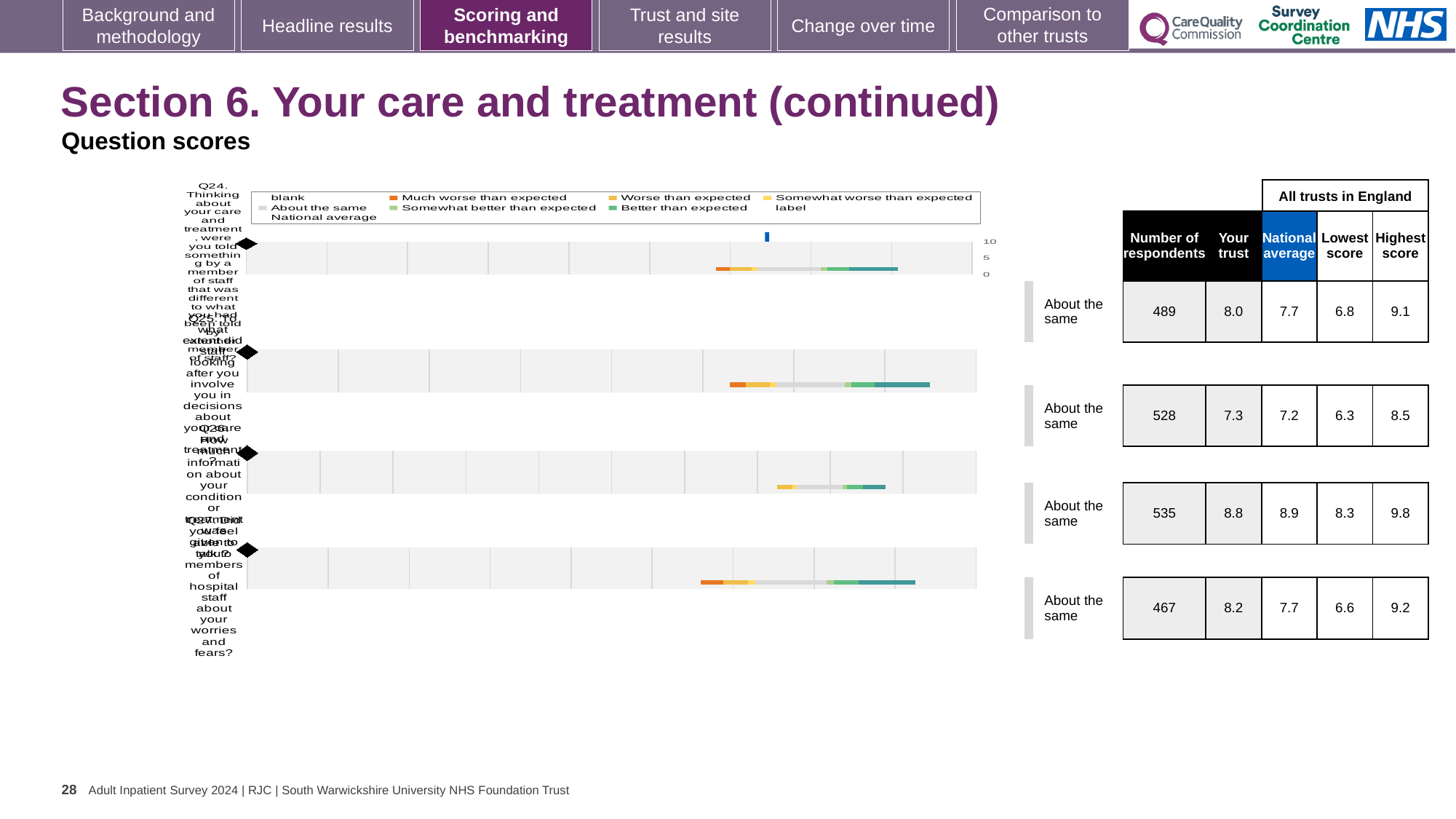
What benchmark category is shown for Q24? About the same Which question has the lowest 'Your trust' score? Q25 What is the national average score for Q26 (how much information about your condition or treatment was given to you)? 8.9 What is the highest score among all trusts in England for Q27 (feeling able to talk to staff about worries and fears)? 9.2 For Q26, which is larger: the trust's score or the national average? National average How many questions (rows) are plotted in the chart? 4 How many respondents answered Q25 (involvement in decisions about your care and treatment)? 528 How many entries does the chart legend list? 9 What is the 'Your trust' score for Q24 (being told something different to what you had been told by another member of staff)? 8.0 What kind of chart is used to show the question scores on this slide? bar chart Which question has the highest 'Your trust' score? Q26 By how much does the trust's score for Q24 exceed the national average? 0.3